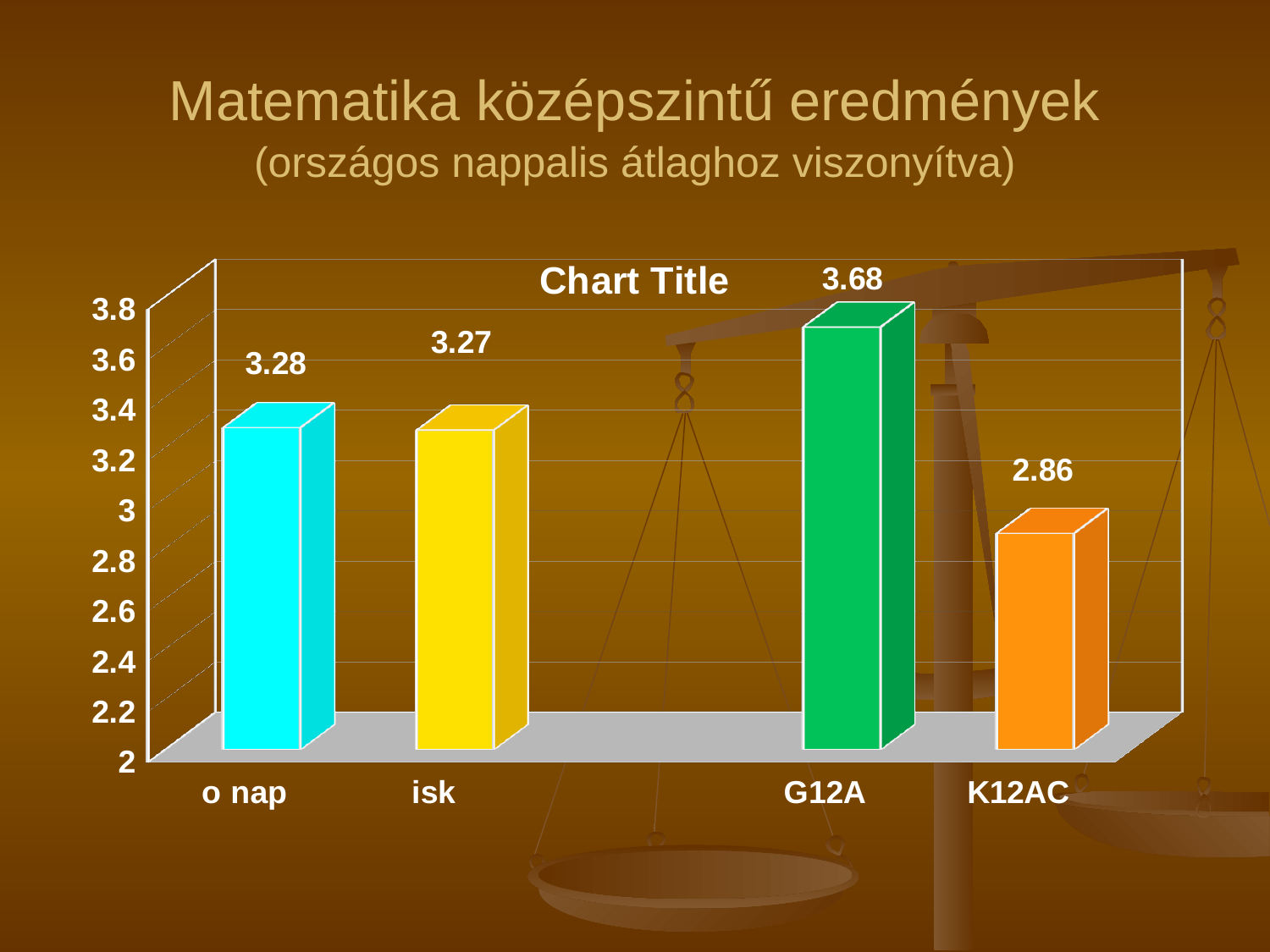
What is the value for isk? 3.27 What is the difference between the values for G12A and K12AC? 0.82 What kind of chart is shown on the slide? bar chart Which category has the highest value? G12A How many bars are shown in the chart? 4 What is the value for K12AC? 2.86 What is the value for G12A? 3.68 Which is larger, the value for G12A or the value for o nap? G12A Is the value for K12AC greater or less than 3? less Which category has the lowest value? K12AC What is the difference between the values for o nap and isk? 0.01 What is the value for o nap? 3.28